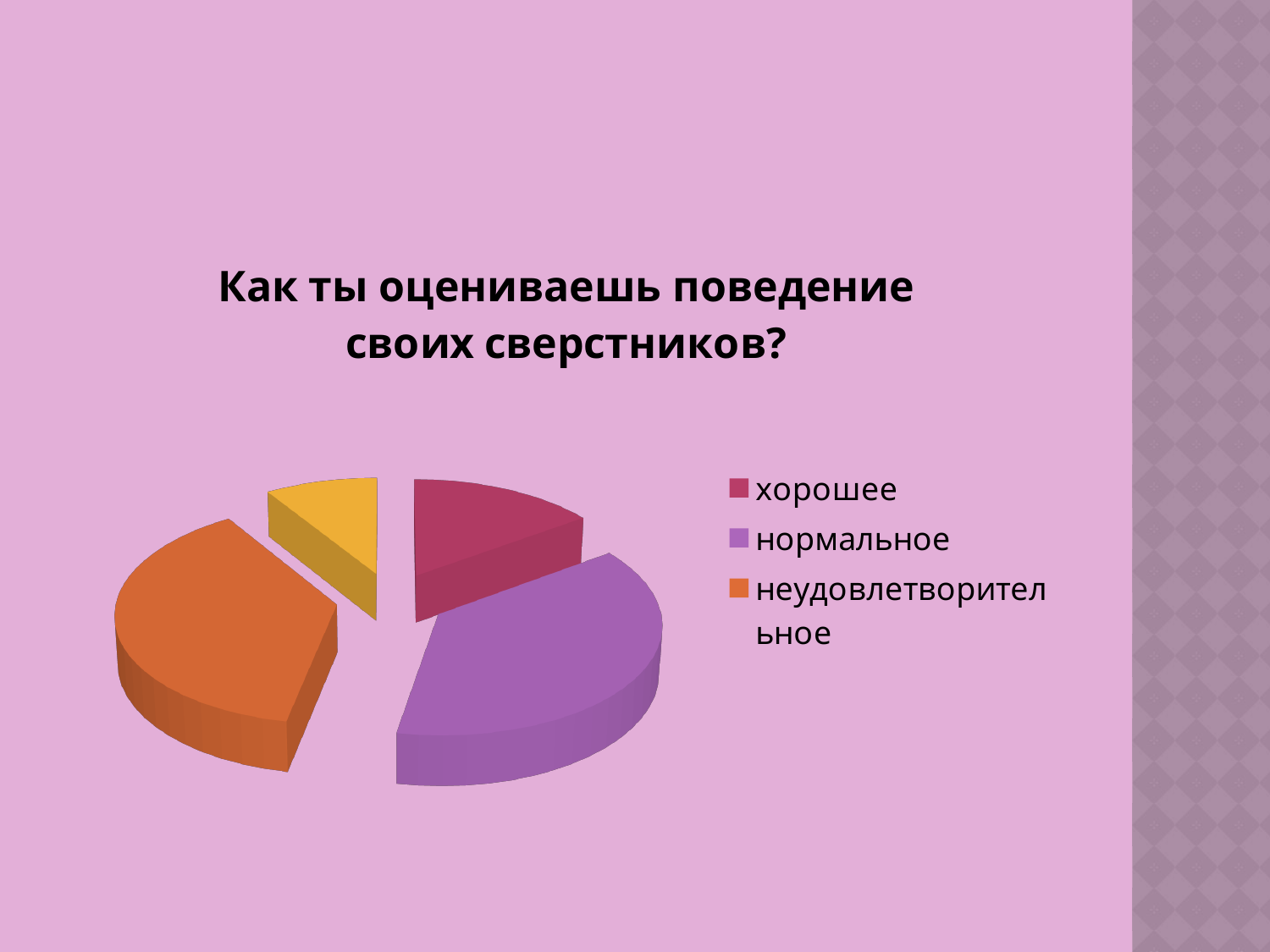
How many slices does the pie chart have? 4 What kind of chart is shown on the slide? pie chart Which of the legend categories has the smallest slice of the pie? хорошее Which slice is larger, нормальное or хорошее? нормальное Which slice is larger, неудовлетворительное or хорошее? неудовлетворительное What is the title of the chart? Как ты оцениваешь поведение своих сверстников? How many entries does the chart's legend list? 3 What colour is the slice for нормальное? purple